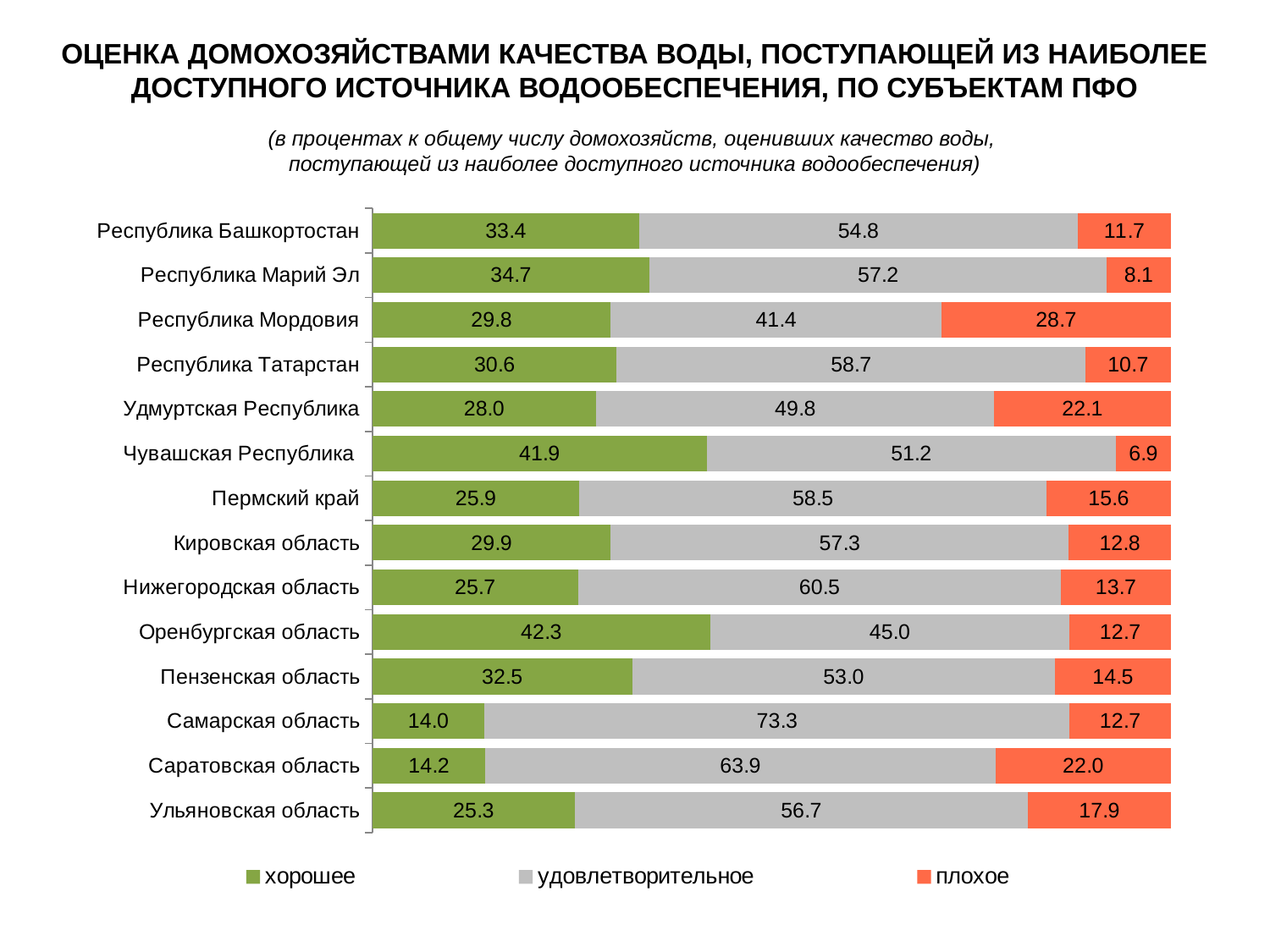
What is the value of плохое for Республика Мордовия? 28.7 What is the total of the stacked bar for Республика Башкортостан? 99.9 How many series does the legend list? 3 Which region has the highest value for удовлетворительное? Самарская область Which is larger: хорошее for Республика Татарстан or хорошее for Кировская область? Республика Татарстан What is the value of удовлетворительное for Самарская область? 73.3 What is the value of хорошее for Чувашская Республика? 41.9 How many regions are shown on the chart? 14 What kind of chart is shown on the slide? Stacked bar chart Which region has the highest value for плохое? Республика Мордовия Which region has the lowest value for плохое? Чувашская Республика What is the difference between плохое and хорошее for Саратовская область? 7.8